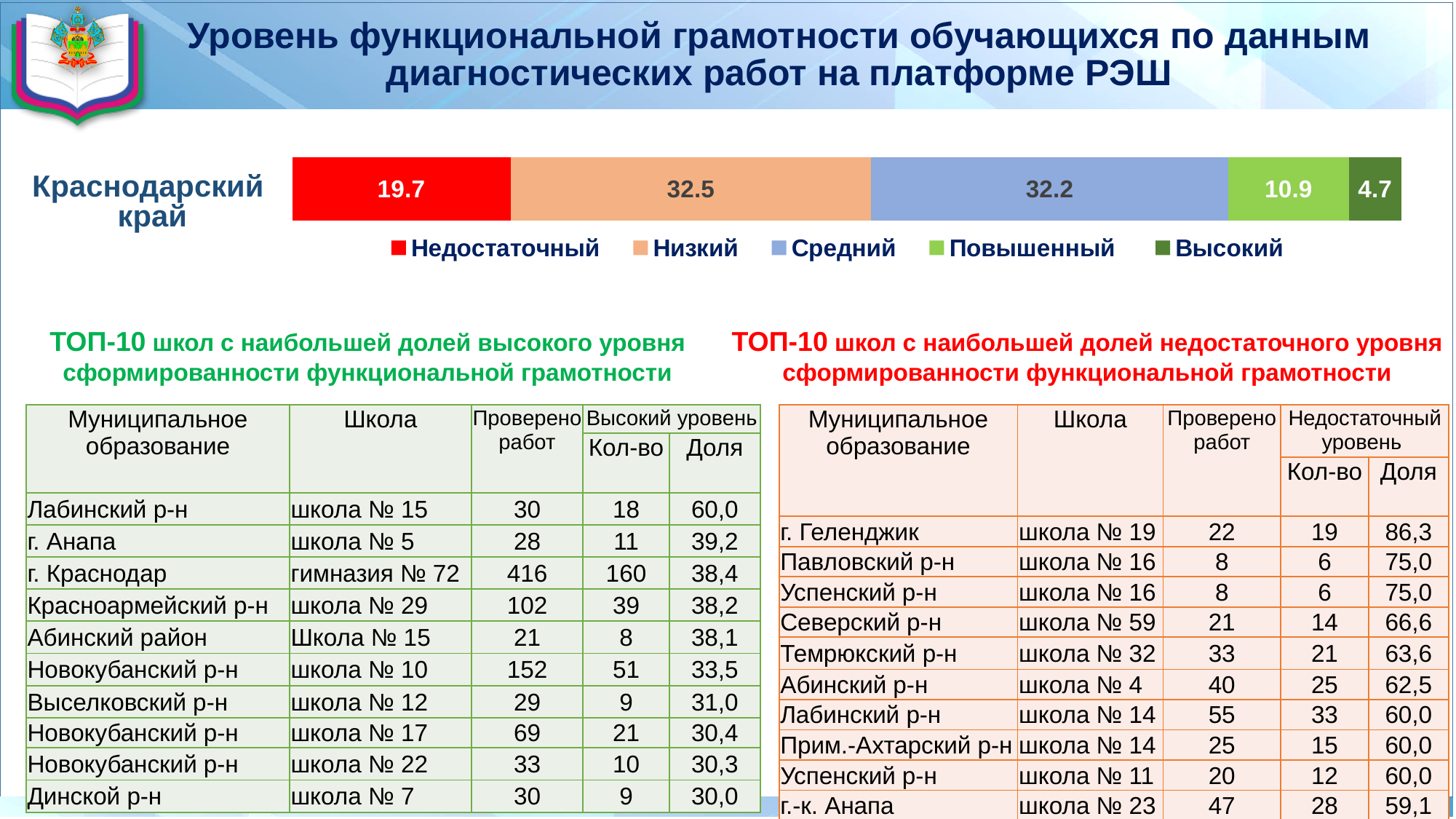
What is the total of all segments in the stacked bar for Краснодарский край? 100.0 What is the difference between the Низкий and Недостаточный values in the stacked bar for Краснодарский край? 12.8 What is the value of the Высокий segment in the stacked bar for Краснодарский край? 4.7 What kind of chart shows the levels for Краснодарский край? Stacked bar chart How many series does the legend of the stacked bar chart list? 5 Which level has the largest segment in the stacked bar for Краснодарский край? Низкий What is the value of the Недостаточный segment in the stacked bar for Краснодарский край? 19.7 What is the value of the Повышенный segment in the stacked bar for Краснодарский край? 10.9 What is the value of the Низкий segment in the stacked bar for Краснодарский край? 32.5 What is the value of the Средний segment in the stacked bar for Краснодарский край? 32.2 Which is larger in the stacked bar for Краснодарский край: Недостаточный or Повышенный? Недостаточный Which level has the smallest segment in the stacked bar for Краснодарский край? Высокий